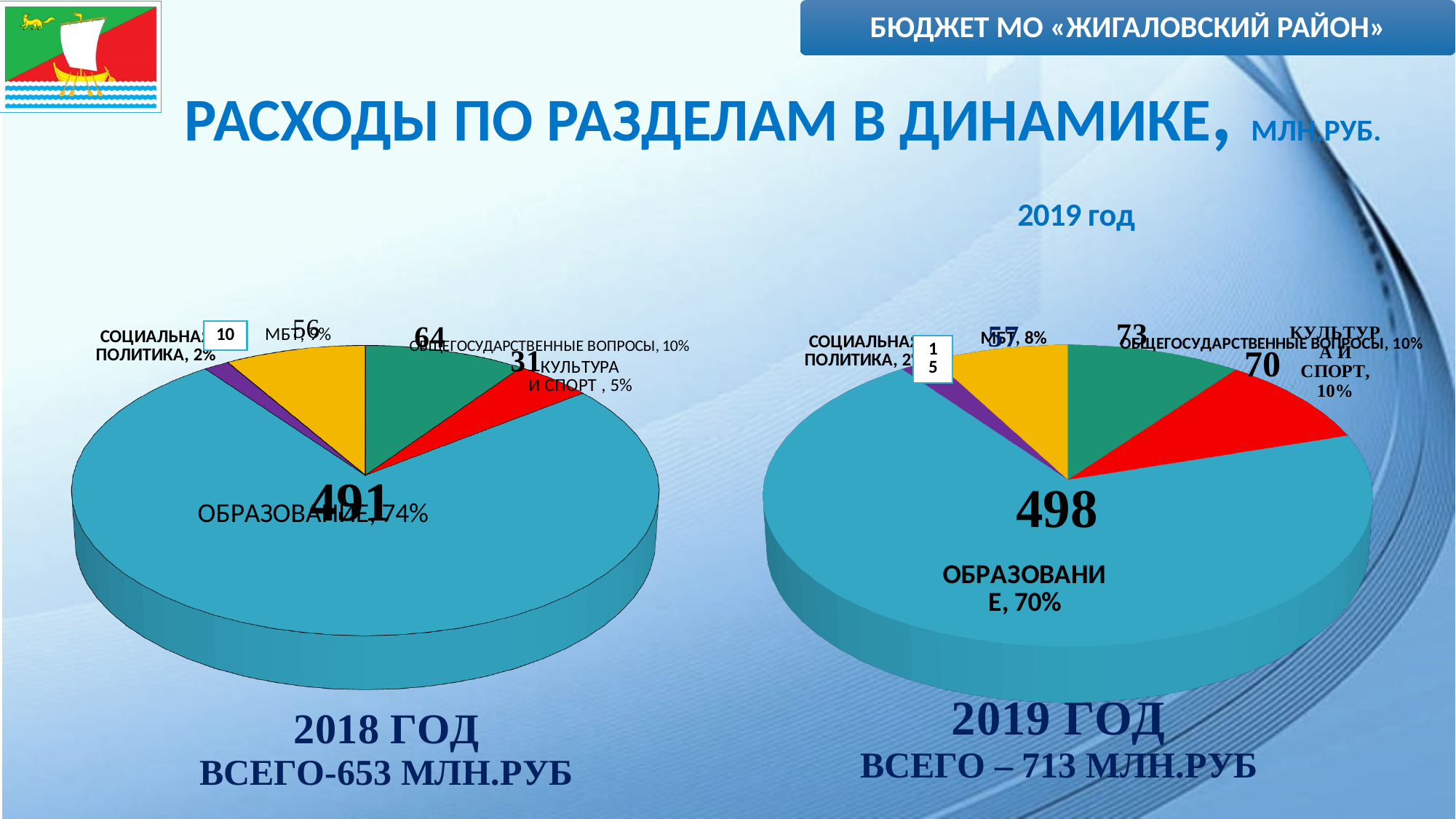
In the 2018 pie chart, which category has the smallest value? СОЦИАЛЬНАЯ ПОЛИТИКА In the 2018 pie chart, what is the value for ОБРАЗОВАНИЕ? 491 How many categories does the 2018 pie chart show? 5 What type of chart is used for the 2018 data? Pie chart In the 2019 pie chart, which category has the largest value? ОБРАЗОВАНИЕ Which is larger: КУЛЬТУРА И СПОРТ in the 2018 chart or in the 2019 chart? 2019 In the 2018 pie chart, what share of the pie does ОБРАЗОВАНИЕ take? 74% In the 2019 pie chart, what is the value for КУЛЬТУРА И СПОРТ? 70 What is the difference between the ОБРАЗОВАНИЕ value in the 2019 chart and in the 2018 chart? 7 In the 2019 pie chart, what is the value for ОБРАЗОВАНИЕ? 498 In the 2018 pie chart, what is the value for ОБЩЕГОСУДАРСТВЕННЫЕ ВОПРОСЫ? 64 In the 2019 pie chart, what share of the pie does МБТ take? 8%